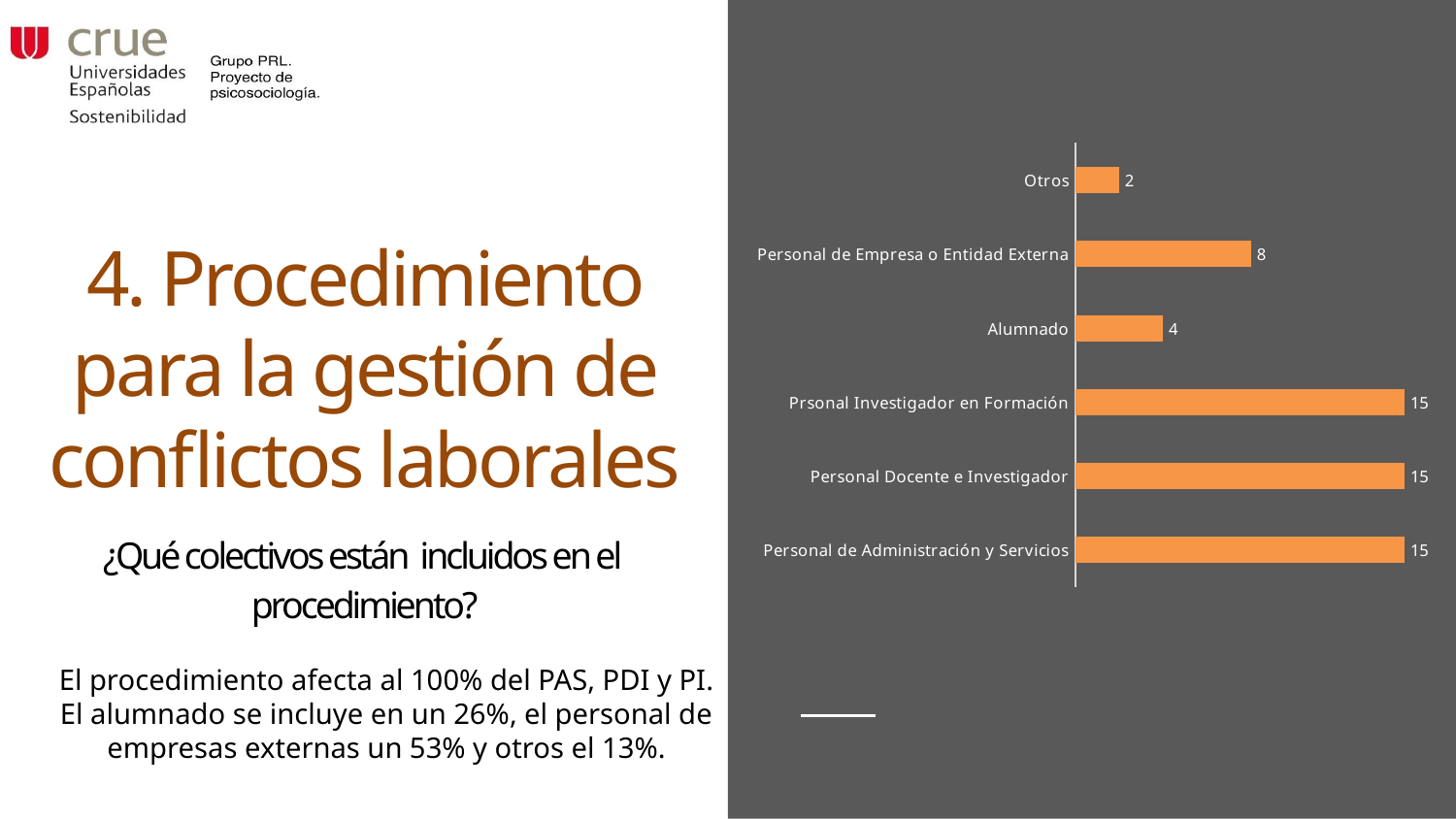
What is the difference between the values for Personal Docente e Investigador and Otros? 13 What kind of chart is shown on the slide? Bar chart What is the value for Alumnado? 4 What is the value for Personal de Empresa o Entidad Externa? 8 What colour are the bars in the chart? Orange How many categories are shown in the chart? 6 What is the value for Otros? 2 Which category has the lowest value? Otros What is the value for Personal Docente e Investigador? 15 Which is larger, the value for Alumnado or the value for Personal de Empresa o Entidad Externa? Personal de Empresa o Entidad Externa What is the value for Personal de Administración y Servicios? 15 What is the difference between the values for Personal de Empresa o Entidad Externa and Alumnado? 4